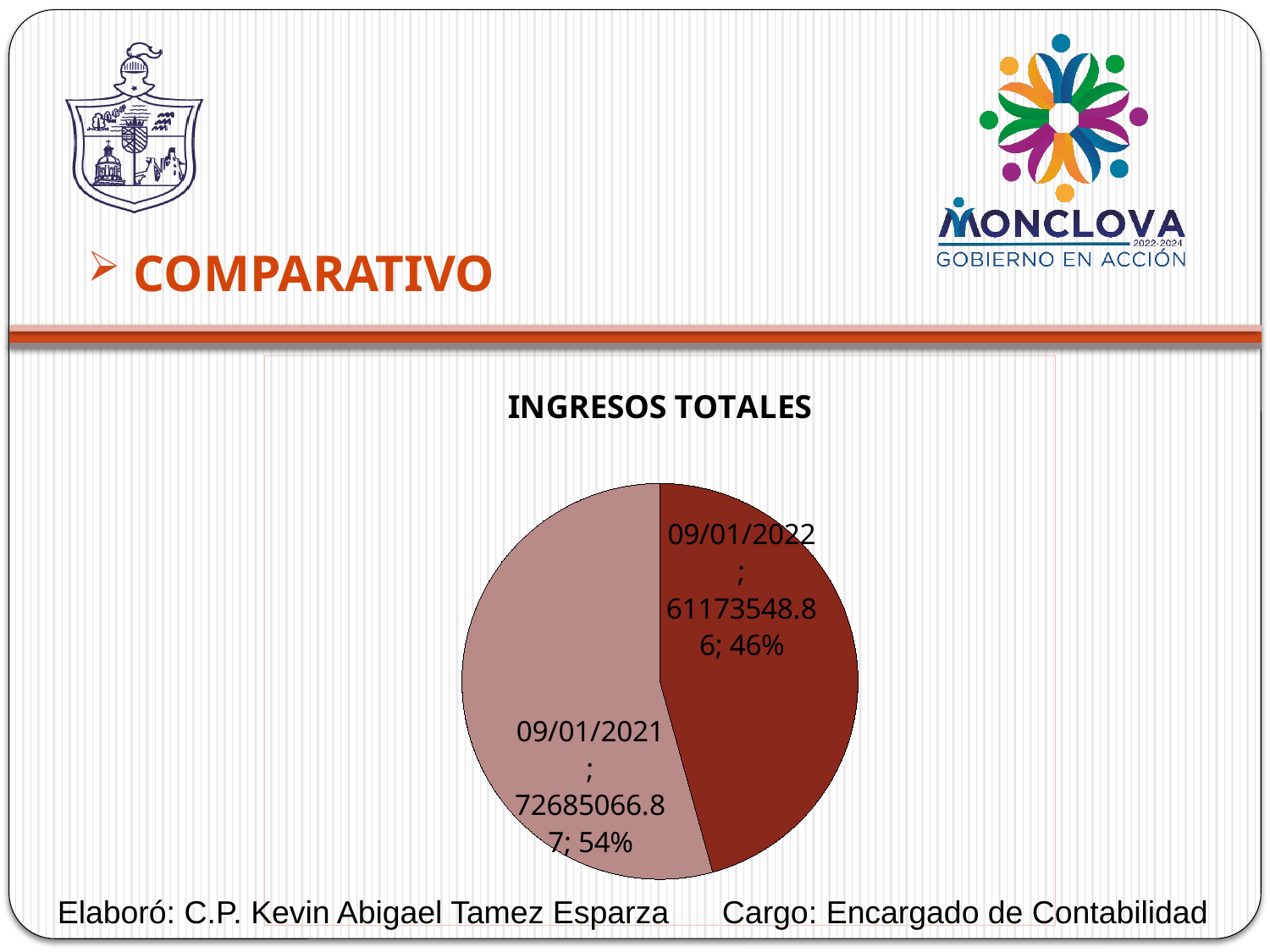
What share of the pie does the 09/01/2021 slice represent? 54% Which date has the smaller slice of the pie? 09/01/2022 What is the value for 09/01/2021? 72685066.87 What is the difference between the value for 09/01/2021 and the value for 09/01/2022? 11511518.01 What is the title of the chart? INGRESOS TOTALES What is the value for 09/01/2022? 61173548.86 How many slices does the pie chart have? 2 What share of the pie does the 09/01/2022 slice represent? 46% What colour is the 09/01/2022 slice? dark red Which date has the larger slice of the pie? 09/01/2021 What type of chart is shown on the slide? pie chart Which is larger, the value for 09/01/2021 or the value for 09/01/2022? 09/01/2021